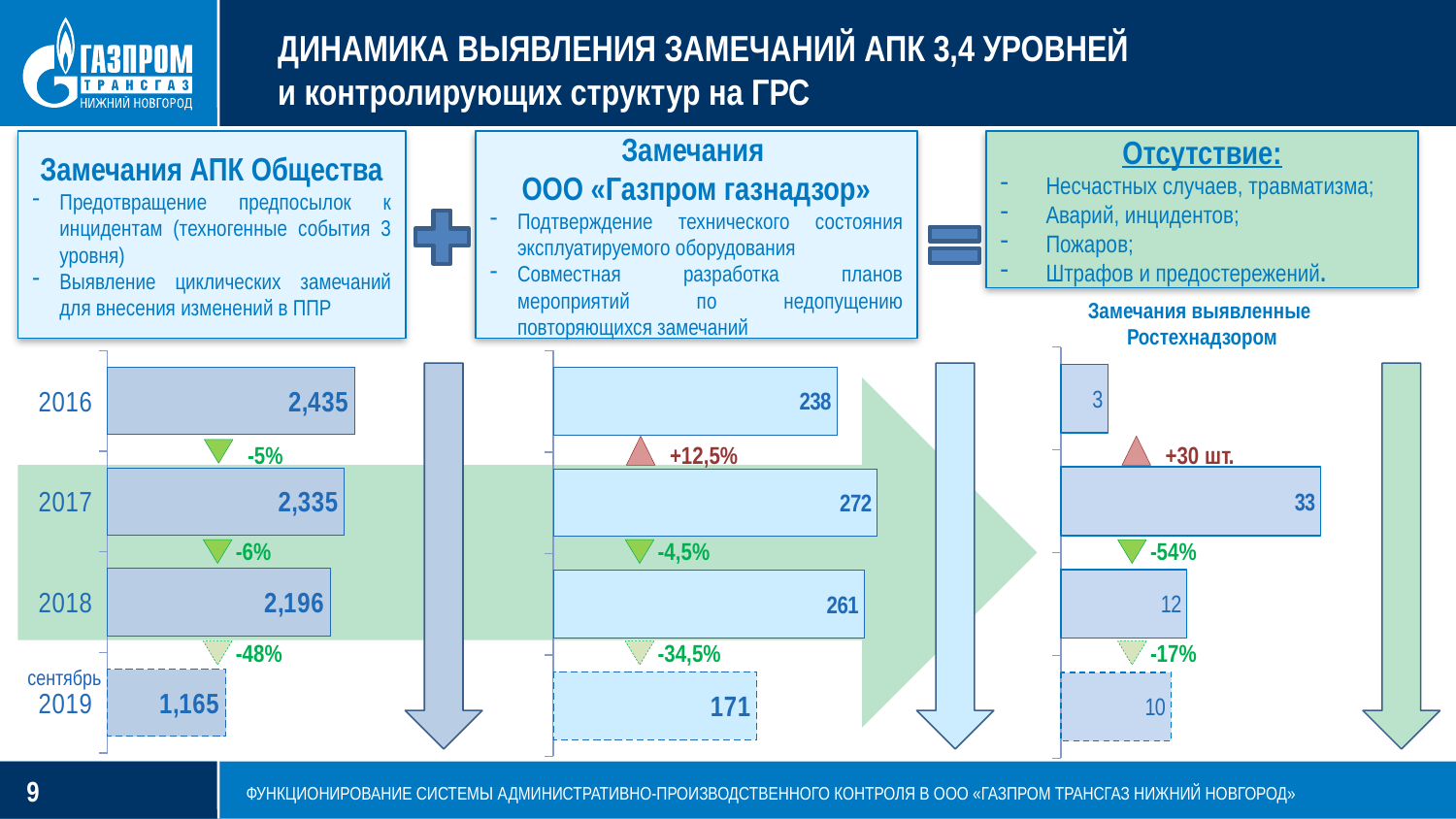
In the right chart (Замечания выявленные Ростехнадзором), what is the value for 2018? 12 In the left chart (Замечания АПК Общества), what is the value for 2016? 2,435 In the middle chart (Замечания ООО «Газпром газнадзор»), which is larger: the value for 2016 or the value for 2018? 2018 What type of chart is used for Замечания выявленные Ростехнадзором? Bar chart In the middle chart (Замечания ООО «Газпром газнадзор»), what is the value for 2017? 272 In the left chart (Замечания АПК Общества), what is the value for сентябрь 2019? 1,165 In the middle chart (Замечания ООО «Газпром газнадзор»), which year has the highest value? 2017 In the right chart (Замечания выявленные Ростехнадзором), which category has the lowest value? 2016 In the left chart (Замечания АПК Общества), what is the difference between the 2016 and 2017 values? 100 How many categories (time periods) are shown in the left chart (Замечания АПК Общества)? 4 In the middle chart (Замечания ООО «Газпром газнадзор»), what percentage change is shown between 2016 and 2017? +12,5% In the left chart (Замечания АПК Общества), do the values rise or fall from 2016 to сентябрь 2019? Fall